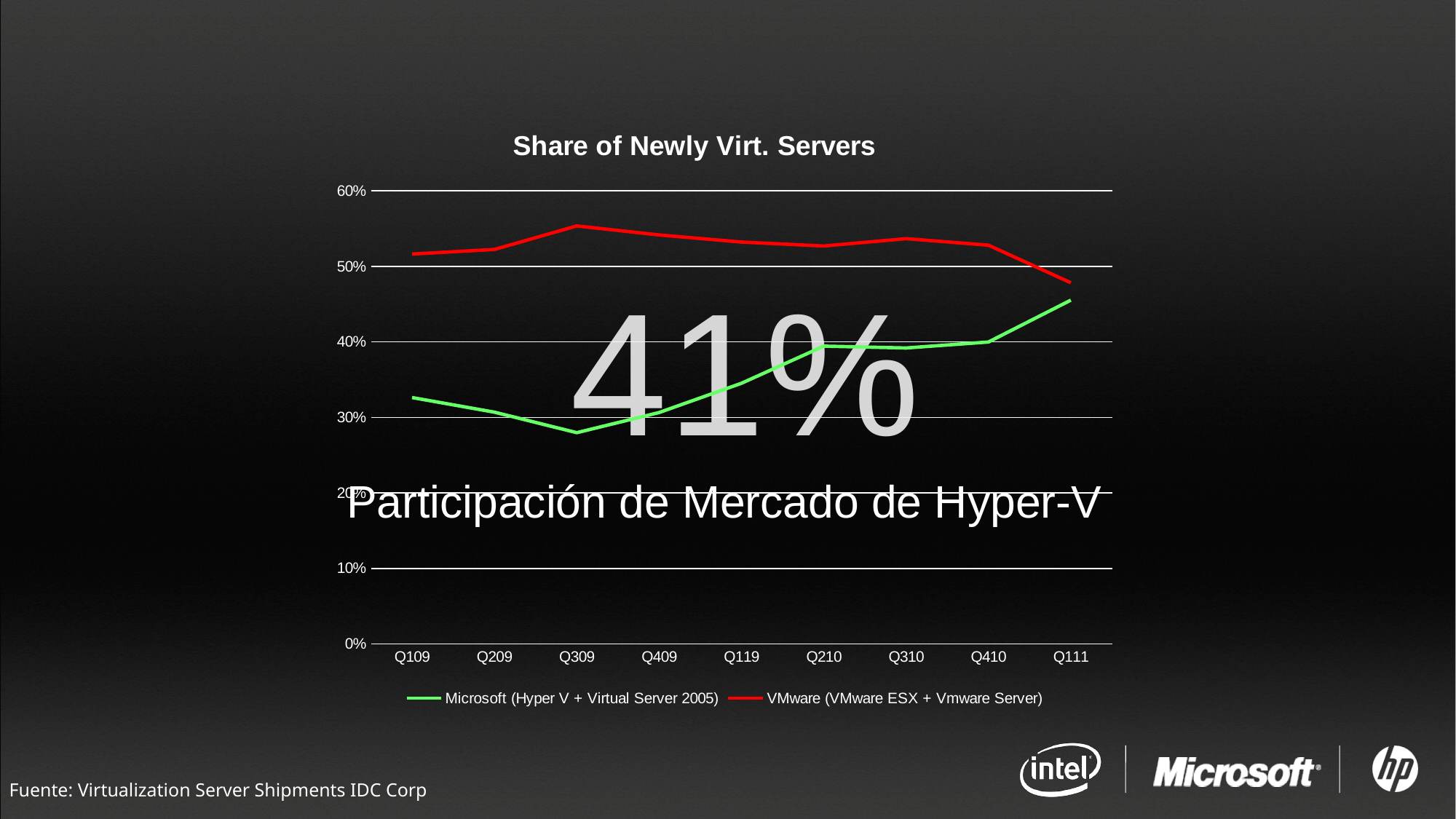
Is the value for VMware (VMware ESX + Vmware Server) in Q111 greater or less than 50%? less How many quarters are plotted along the x axis of the chart? 9 In Q109, which series has the higher share, Microsoft or VMware? VMware In which quarter does the Microsoft (Hyper V + Virtual Server 2005) line reach its highest value? Q111 Is the value for Microsoft (Hyper V + Virtual Server 2005) in Q309 greater or less than 30%? less Does the Microsoft (Hyper V + Virtual Server 2005) line rise or fall between Q309 and Q111? Rise What kind of chart is shown on the slide? Line chart In which quarter does the Microsoft (Hyper V + Virtual Server 2005) line reach its lowest value? Q309 Which series is drawn with the red line? VMware (VMware ESX + Vmware Server) How many series does the legend of the chart list? 2 What is the title of the chart? Share of Newly Virt. Servers In which quarter does the VMware (VMware ESX + Vmware Server) line reach its lowest value? Q111